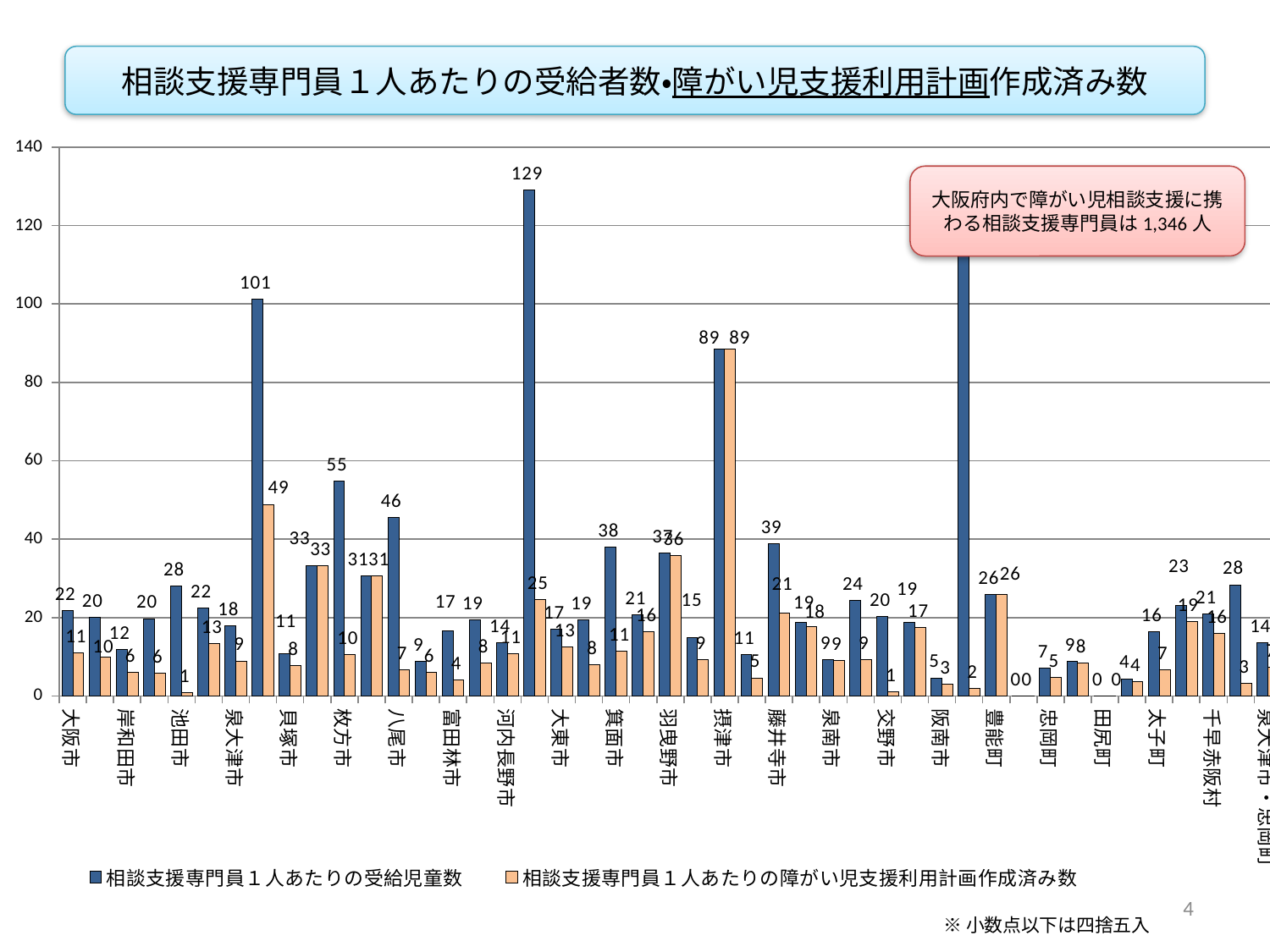
Is the value of 相談支援専門員１人あたりの受給児童数 for 摂津市 greater or less than 80? greater How many series does the legend list? 2 What is the value of 相談支援専門員１人あたりの受給児童数 for 摂津市? 89 Which labelled category has the highest value for 相談支援専門員１人あたりの障がい児支援利用計画作成済み数? 摂津市 What is the value of 相談支援専門員１人あたりの障がい児支援利用計画作成済み数 for 八尾市? 7 What kind of chart is shown on the slide? bar chart According to the callout on the chart, how many 相談支援専門員 in 大阪府 are involved in 障がい児相談支援? 1,346 人 What is the difference between the two series for 枚方市? 45 What is the value of 相談支援専門員１人あたりの受給児童数 for 豊能町? 26 Which is larger: the 相談支援専門員１人あたりの受給児童数 value for 枚方市 or for 八尾市? 枚方市 What is the value of 相談支援専門員１人あたりの障がい児支援利用計画作成済み数 for 摂津市? 89 What is the value of 相談支援専門員１人あたりの受給児童数 for 枚方市? 55